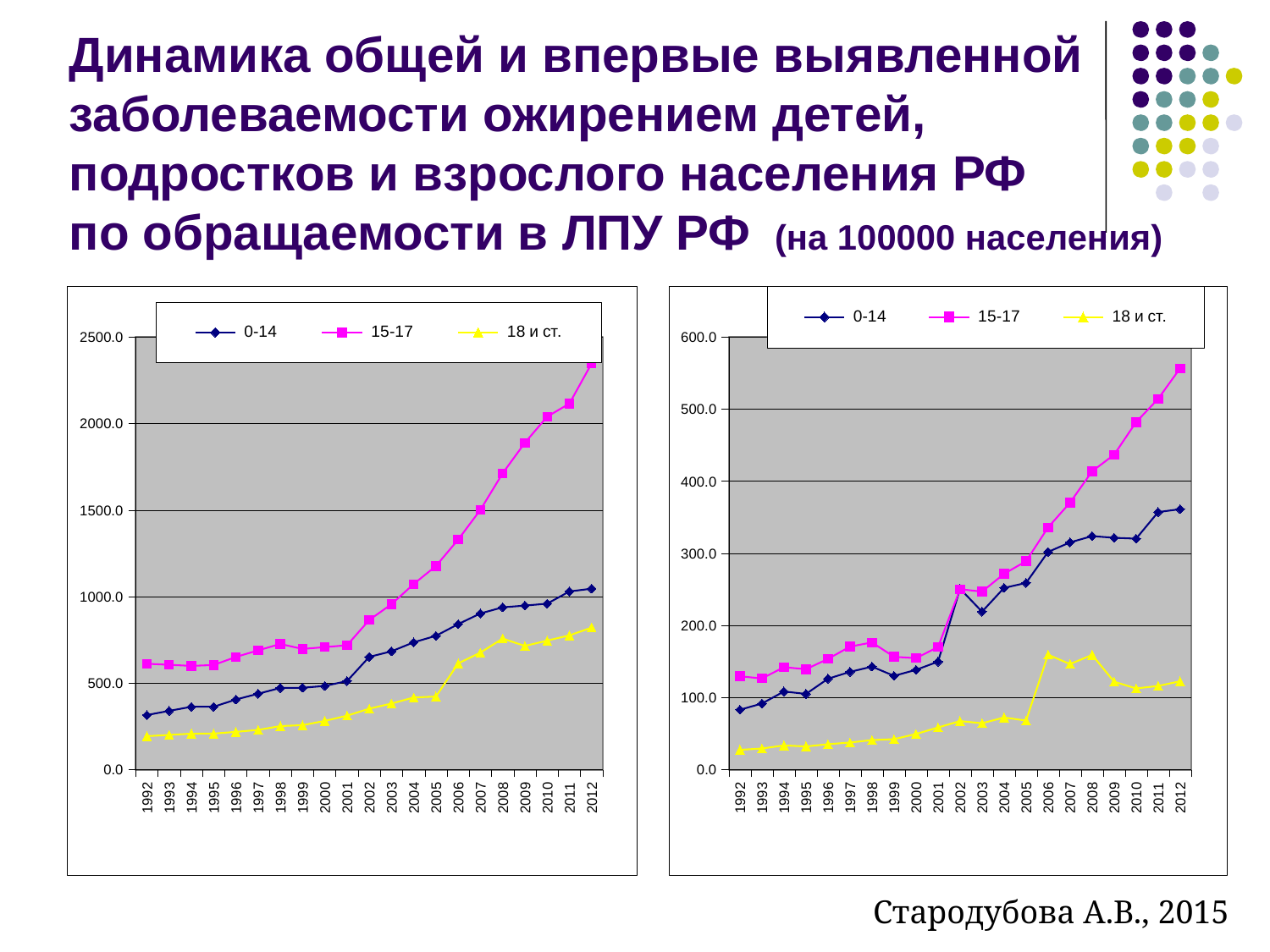
In the left chart, is the value for the 18 и ст. series in 2012 greater or less than 1000.0? less What kind of chart is the left chart on the slide? line chart In the right chart, which series has the higher value in 2012: 0-14 or 18 и ст.? 0-14 In the left chart, which series has the highest value in 2012? 15-17 In the right chart, does the 15-17 series generally rise or fall from 1992 to 2012? rise In the right chart, is the value for the 0-14 series in 2012 greater or less than 400.0? less What are the three series named in the legend of the left chart? 0-14, 15-17, 18 и ст. In the left chart, is the value for the 15-17 series in 2012 greater or less than 2000.0? greater How many series does the legend of the right chart list? 3 How many years are plotted along the x axis of the left chart? 21